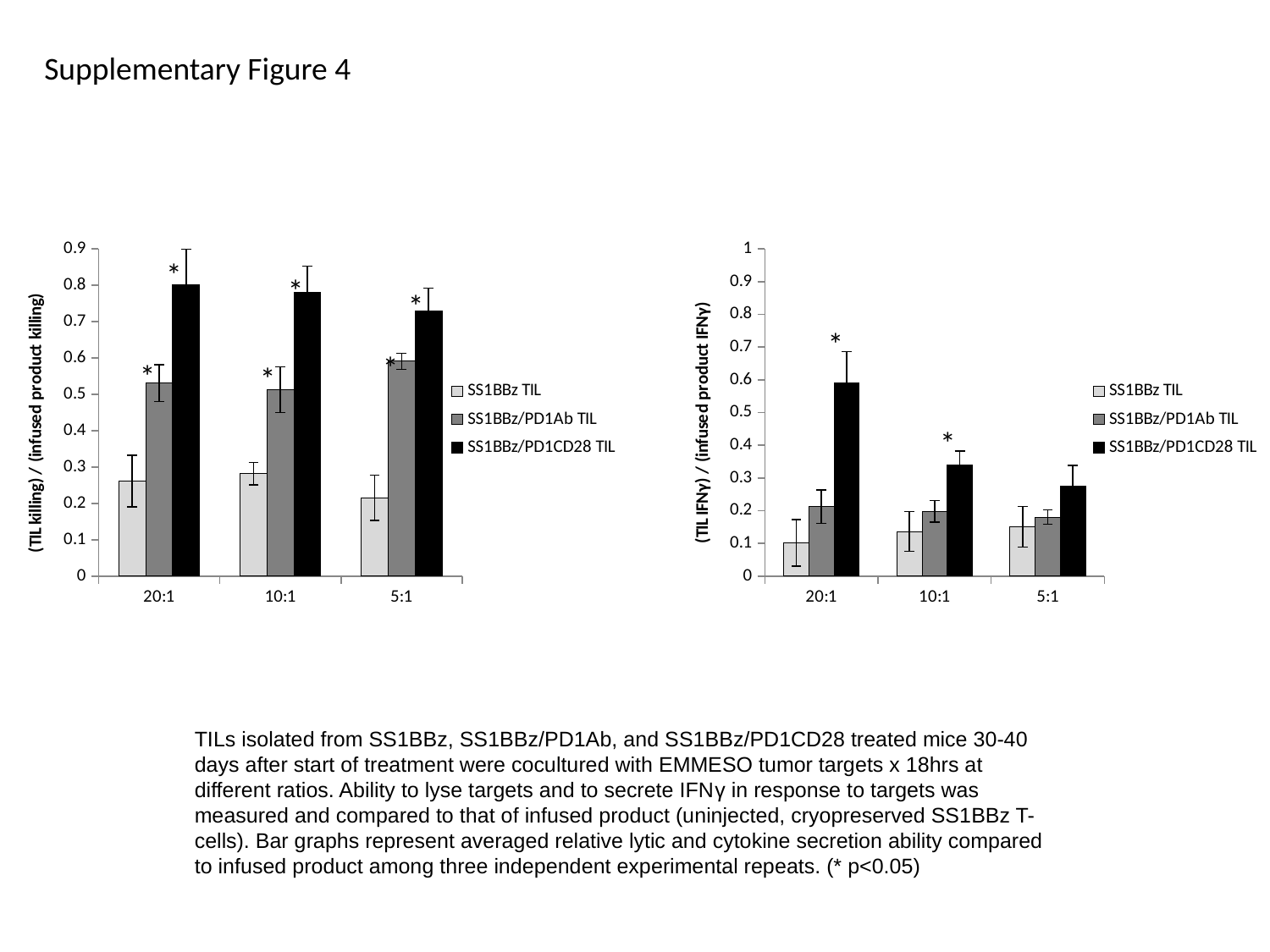
In the right chart (TIL IFNγ), do the values for SS1BBz/PD1CD28 TIL rise or fall from 20:1 to 5:1? fall In the left chart (TIL killing), which series has the highest bar at the 20:1 ratio? SS1BBz/PD1CD28 TIL In the left chart (TIL killing), at the 5:1 ratio, which is larger: SS1BBz TIL or SS1BBz/PD1Ab TIL? SS1BBz/PD1Ab TIL In the right chart (TIL IFNγ), is the value for SS1BBz/PD1CD28 TIL at 20:1 greater or less than 0.5? greater In the right chart (TIL IFNγ), which series and ratio has the highest bar overall? SS1BBz/PD1CD28 TIL at 20:1 In the left chart (TIL killing), is the value for SS1BBz/PD1CD28 TIL at 20:1 greater or less than 0.7? greater How many series does the legend of the right chart list? 3 What type of chart is the left chart on the slide? bar chart In the left chart (TIL killing), is the value for SS1BBz TIL at 5:1 greater or less than 0.3? less In the right chart (TIL IFNγ), which series has the lowest bar at the 20:1 ratio? SS1BBz TIL How many categories are shown on the x axis of the left chart? 3